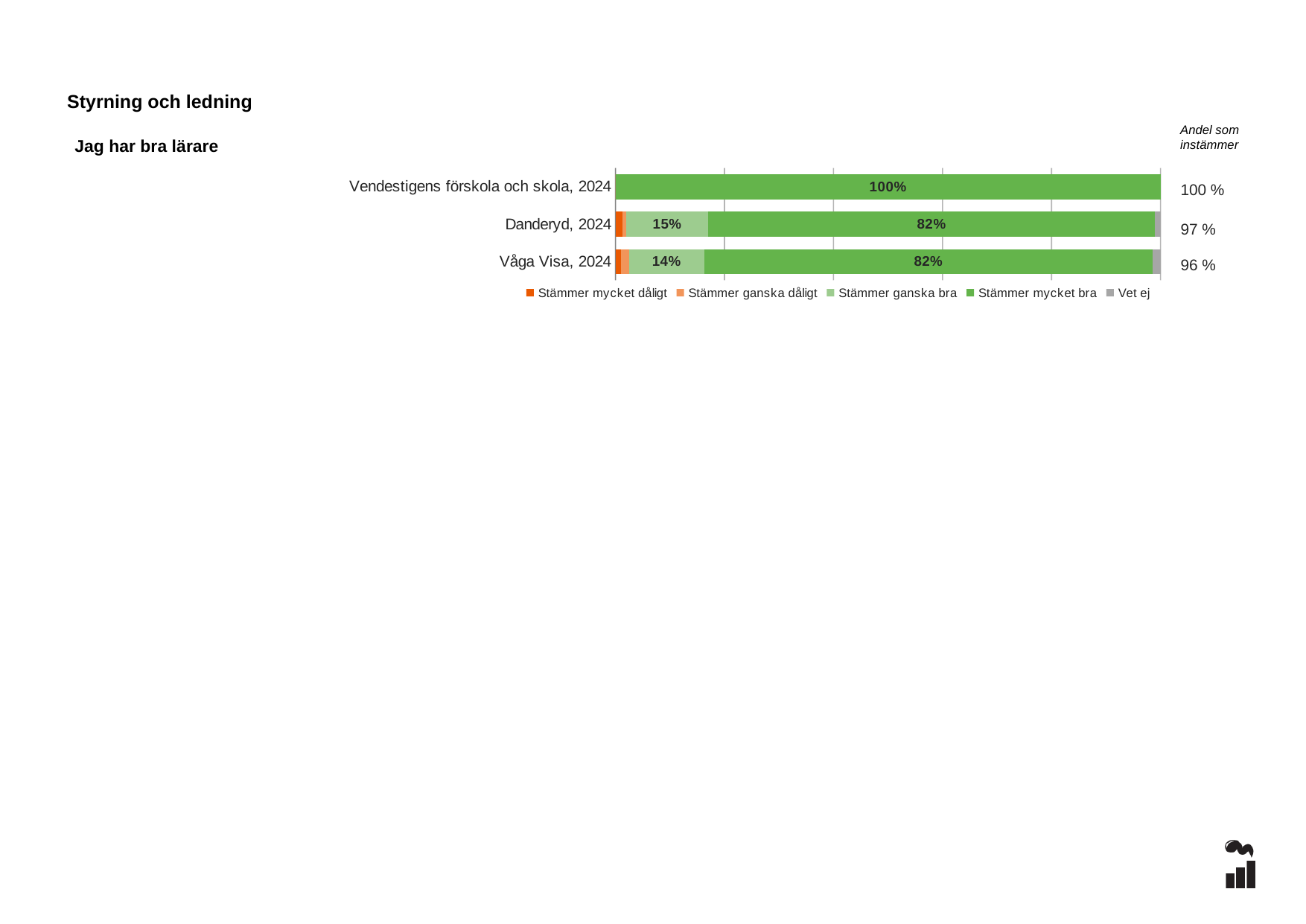
What kind of chart is shown on the slide? Stacked bar chart What is the 'Andel som instämmer' value for Danderyd, 2024? 97 % Which category has the highest 'Stämmer mycket bra' value? Vendestigens förskola och skola, 2024 What is the value of 'Stämmer ganska bra' for Våga Visa, 2024? 14% What is the value of 'Stämmer mycket bra' for Våga Visa, 2024? 82% Which is larger: the 'Stämmer ganska bra' value for Danderyd, 2024 or for Våga Visa, 2024? Danderyd, 2024 What is the value of 'Stämmer ganska bra' for Danderyd, 2024? 15% What is the difference between the 'Stämmer mycket bra' values for Vendestigens förskola och skola, 2024 and Danderyd, 2024? 18% What is the value of 'Stämmer mycket bra' for Vendestigens förskola och skola, 2024? 100% How many series does the legend list? 5 How many categories (rows) does the chart show? 3 What is the title of the question shown above the chart? Jag har bra lärare